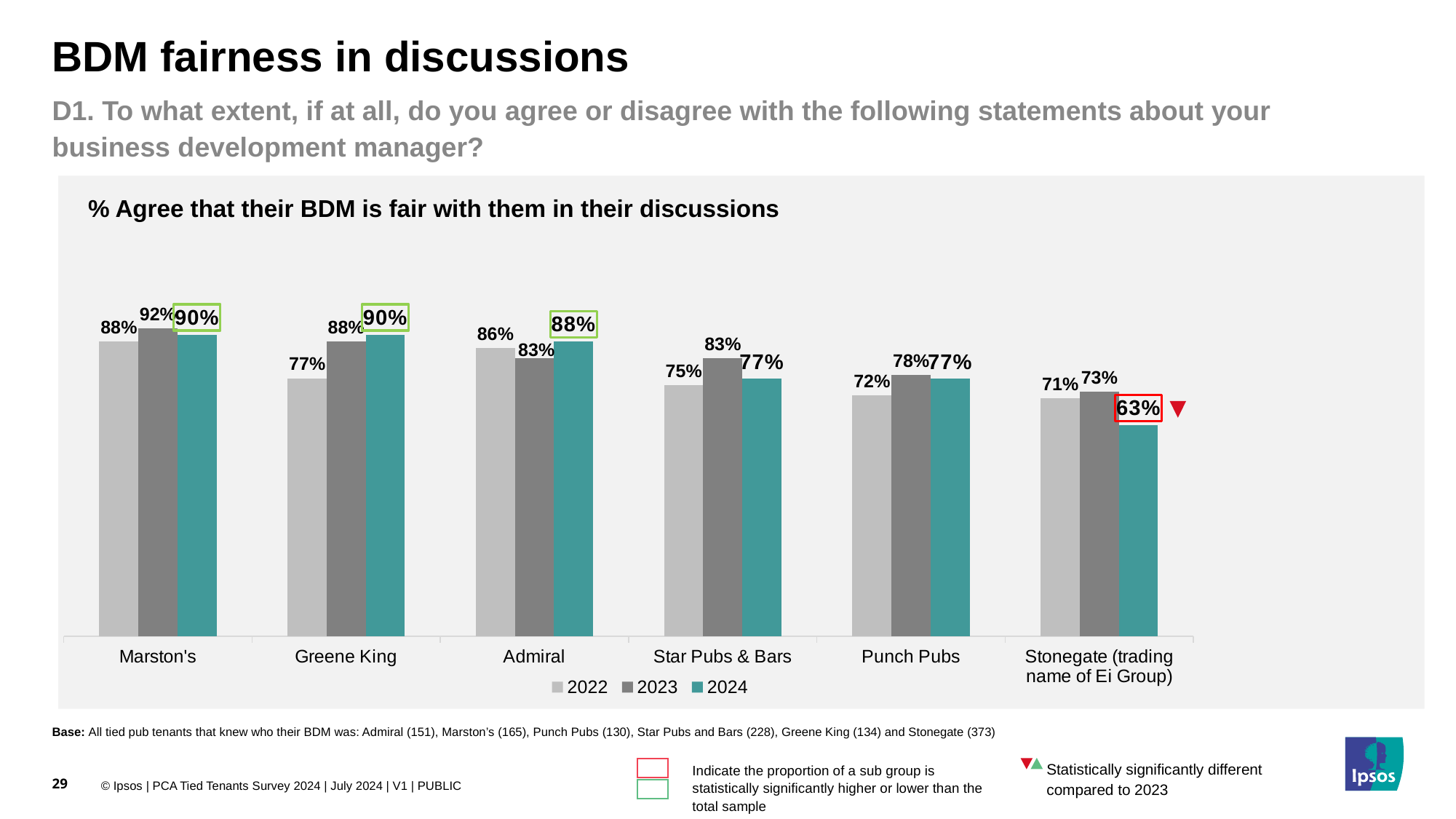
Which pub company has the highest 2023 value? Marston's What is the 2023 value for Star Pubs & Bars? 83% What is the 2022 value for Greene King? 77% What is the 2024 value for Marston's? 90% What is the 2024 value for Stonegate (trading name of Ei Group)? 63% How many series does the legend list? 3 Which pub company has the lowest 2024 value? Stonegate (trading name of Ei Group) What is the title of the chart? % Agree that their BDM is fair with them in their discussions What kind of chart is shown? Bar chart How many pub companies are shown on the x axis? 6 What is the difference between the 2023 and 2024 values for Stonegate (trading name of Ei Group)? 10% Which is larger for Admiral: the 2022 value or the 2023 value? 2022